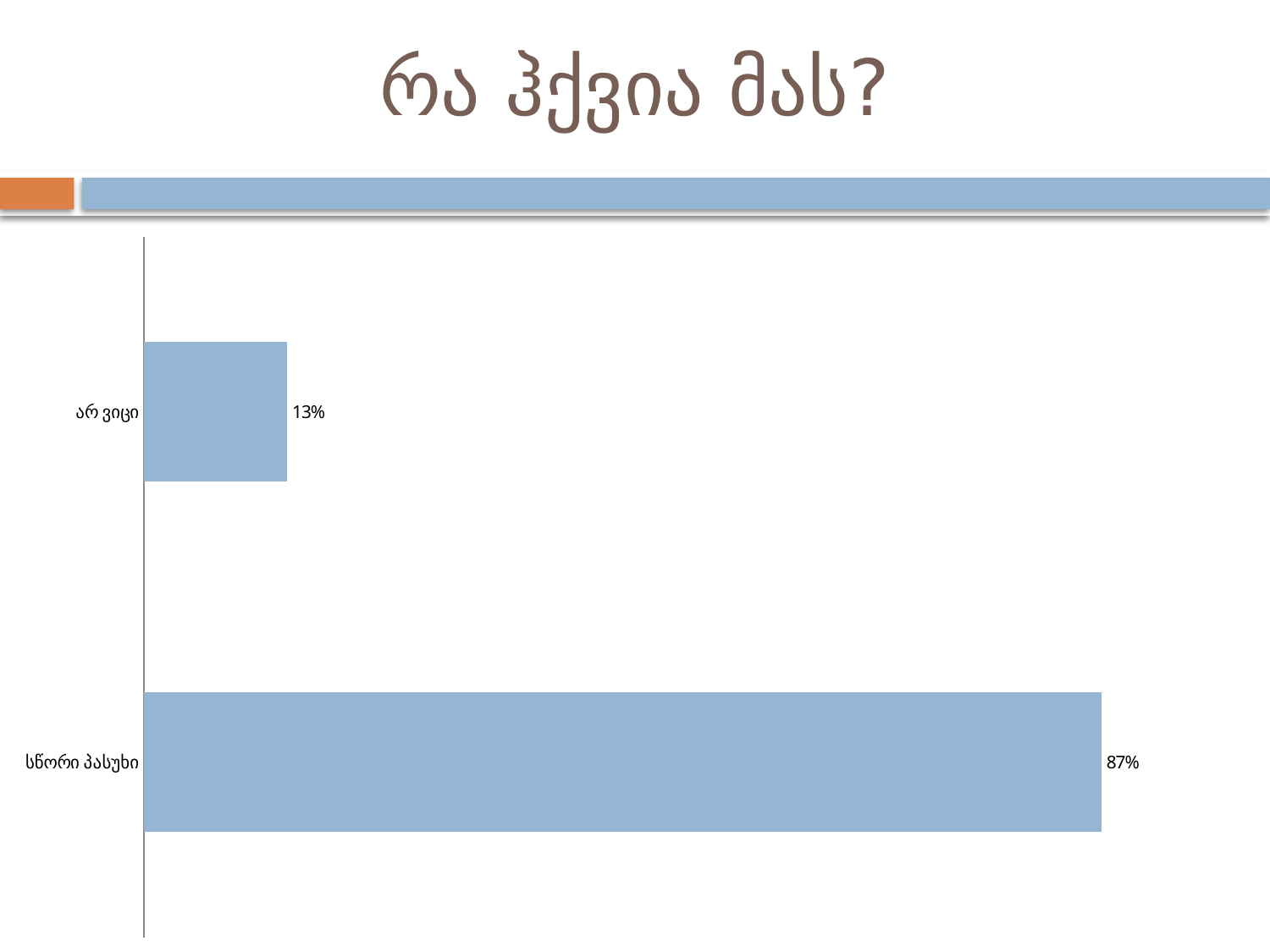
What kind of chart is shown on the slide? bar chart Which is larger, the value for "არ ვიცი" or the value for "სწორი პასუხი"? სწორი პასუხი What is the value for "სწორი პასუხი"? 87% What is the total of the two values shown in the chart? 100% What is the title of the slide? რა ჰქვია მას? Which category has the highest value? სწორი პასუხი What is the difference between the values for "სწორი პასუხი" and "არ ვიცი"? 74% What is the value for "არ ვიცი"? 13% Which category has the lowest value? არ ვიცი What colour are the bars in the chart? light blue How many categories are shown in the chart? 2